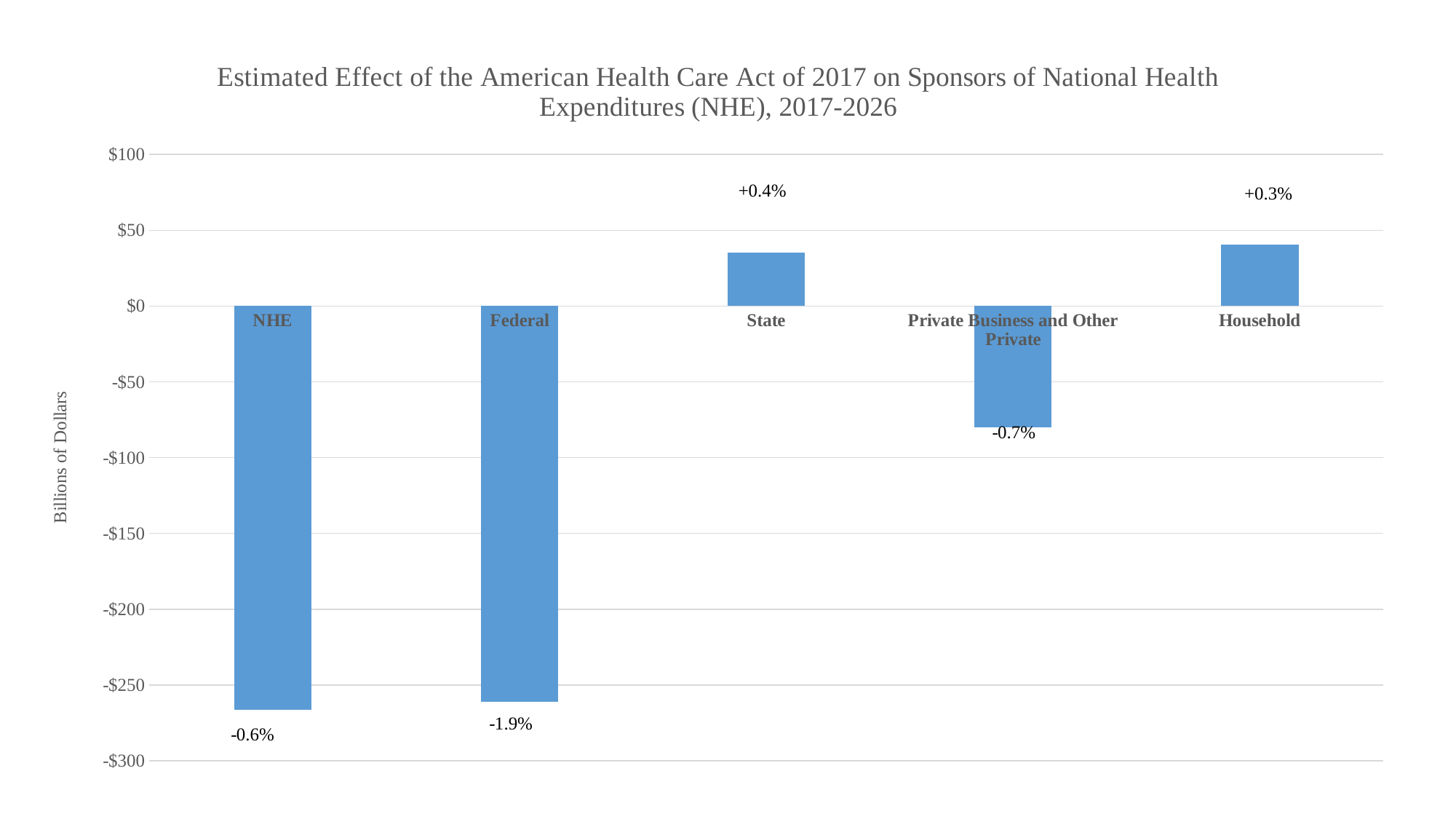
Is the value for State greater or less than $50? less Is the value for Private Business and Other Private greater or less than -$50? less How many categories are plotted on the chart? 5 What percentage change is labelled on the Federal bar? -1.9% What kind of chart is shown on the slide? bar chart What percentage change is labelled on the Private Business and Other Private bar? -0.7% What percentage change is labelled on the Household bar? +0.3% What is the label on the vertical axis? Billions of Dollars What percentage change is labelled on the NHE bar? -0.6% Is the value for NHE greater or less than -$250? less Which is larger, the value for State or the value for Private Business and Other Private? State What percentage change is labelled on the State bar? +0.4%